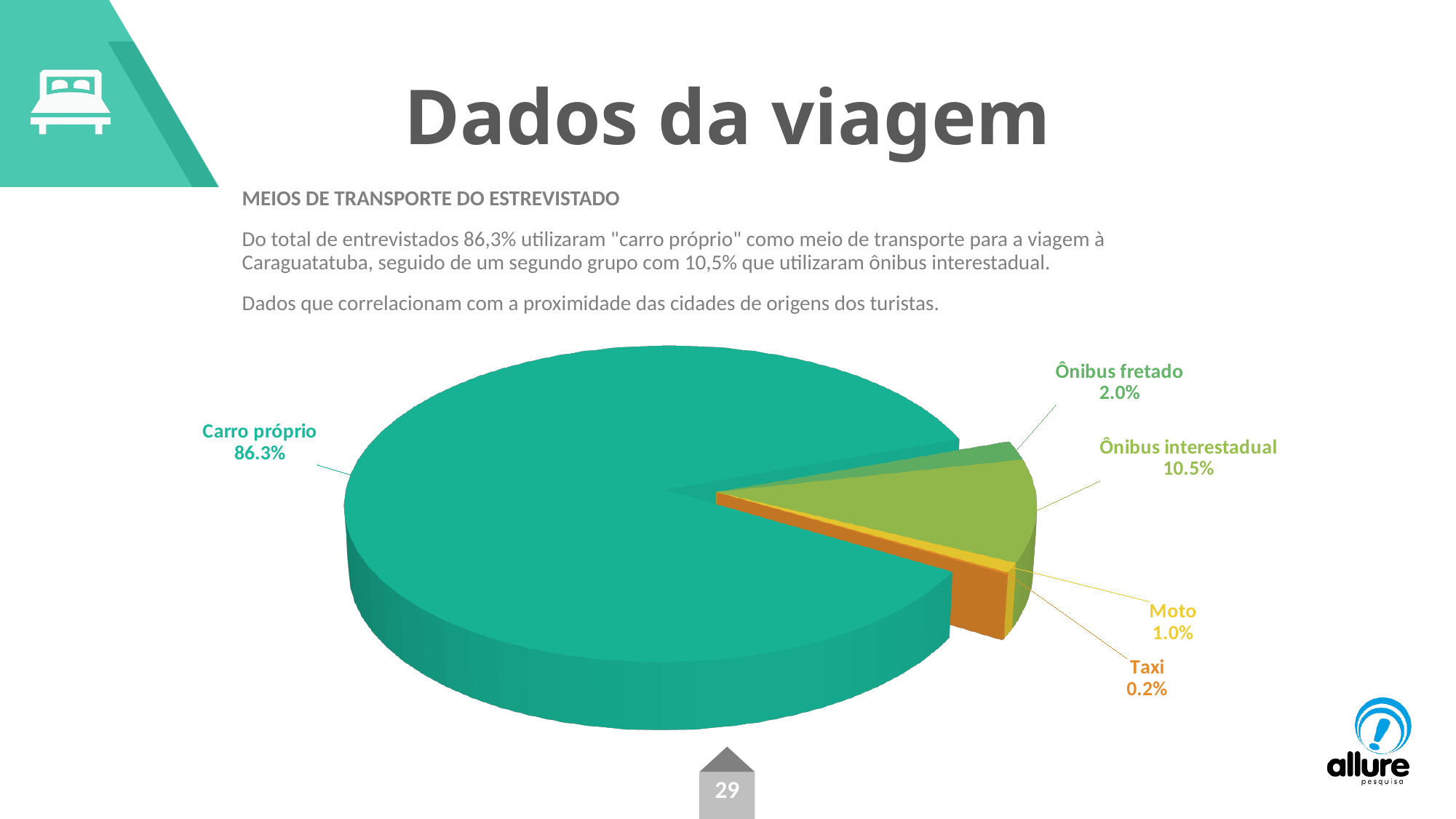
Which category has the largest slice of the pie? Carro próprio Which is larger, Ônibus fretado or Moto? Ônibus fretado What is the value shown for Ônibus interestadual? 10.5% What is the difference in percentage points between Moto and Taxi? 0.8 What is the value shown for Ônibus fretado? 2.0% What type of chart is shown on the slide? Pie chart Which category has the smallest slice of the pie? Taxi What is the value shown for Moto? 1.0% How many categories are shown in the pie chart? 5 What share of the pie does Carro próprio represent? 86.3% What is the value shown for Taxi? 0.2% What is the difference in percentage points between Carro próprio and Ônibus interestadual? 75.8